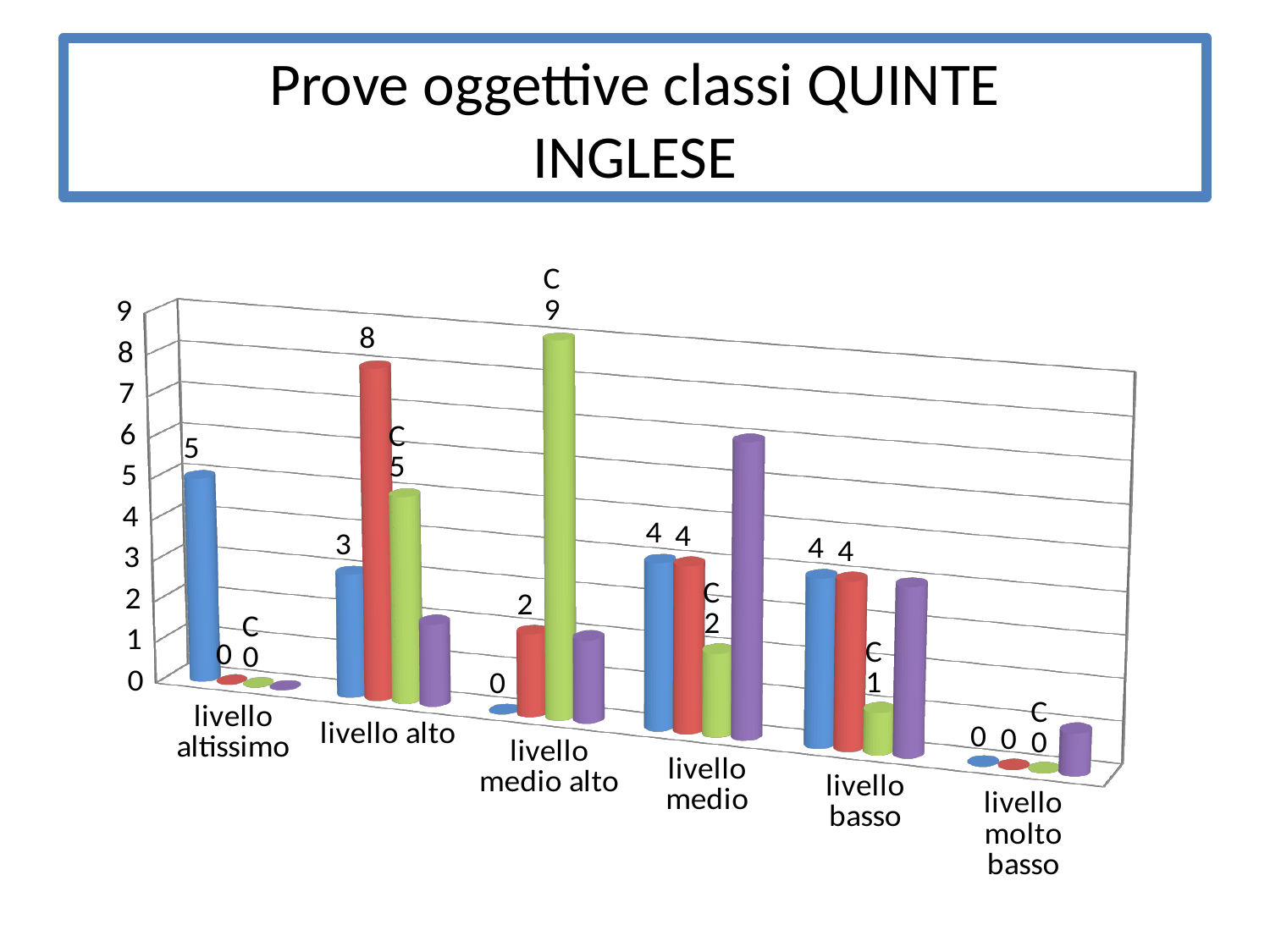
For which category is the green bar (series C) highest? livello medio alto What is the title of the slide? Prove oggettive classi QUINTE INGLESE What is the value of the green bar (series C) for 'livello medio alto'? 9 Is the value of the purple bar for 'livello medio' greater or less than 3? greater How many categories (livello levels) are shown on the x axis? 6 What is the value of the green bar (series C) for 'livello basso'? 1 What is the value of the blue bar for 'livello altissimo'? 5 For which category is the red bar highest? livello alto What type of chart is shown on the slide? bar chart For 'livello alto', which is larger: the blue bar or the red bar? the red bar What is the difference between the red bar and the blue bar for 'livello alto'? 5 What is the value of the red bar for 'livello alto'? 8